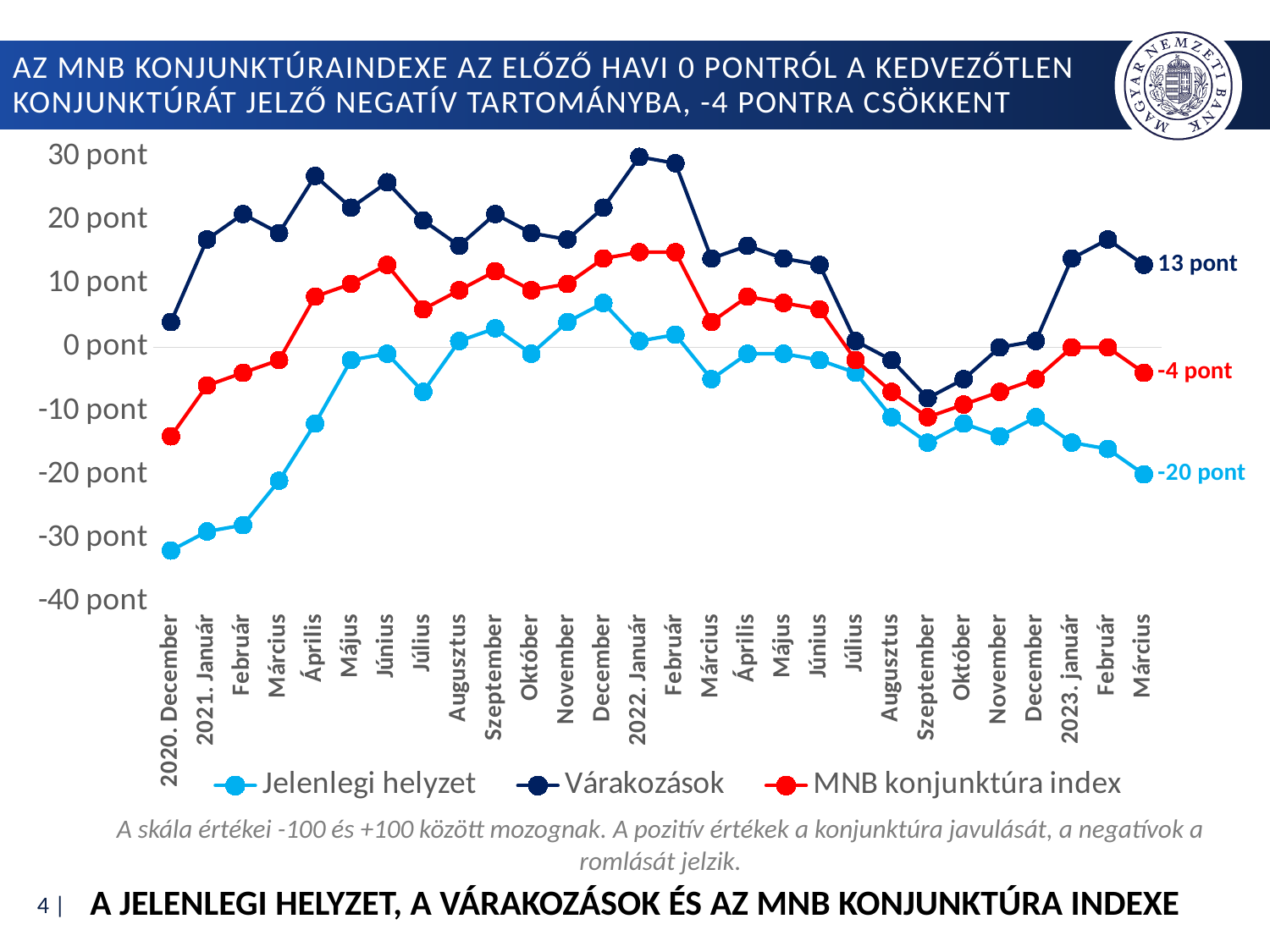
Which series has the highest value in 2023. Március? Várakozások Does the Jelenlegi helyzet series rise or fall between 2020. December and 2021. Június? rise Which series has the lowest value in 2020. December? Jelenlegi helyzet In 2023. Március, what is the difference between the MNB konjunktúra index and Jelenlegi helyzet? 16 pont How many months are plotted on the x axis? 28 In 2023. Március, how many points higher is Várakozások than the MNB konjunktúra index? 17 pont What is the value of Várakozások in 2023. Március? 13 pont What kind of chart is shown on the slide? line chart How many series does the legend list? 3 What is the value of Jelenlegi helyzet in 2023. Március? -20 pont Is the value of Várakozások in 2022. Január greater or less than 20 pont? greater What is the value of the MNB konjunktúra index in 2023. Március? -4 pont